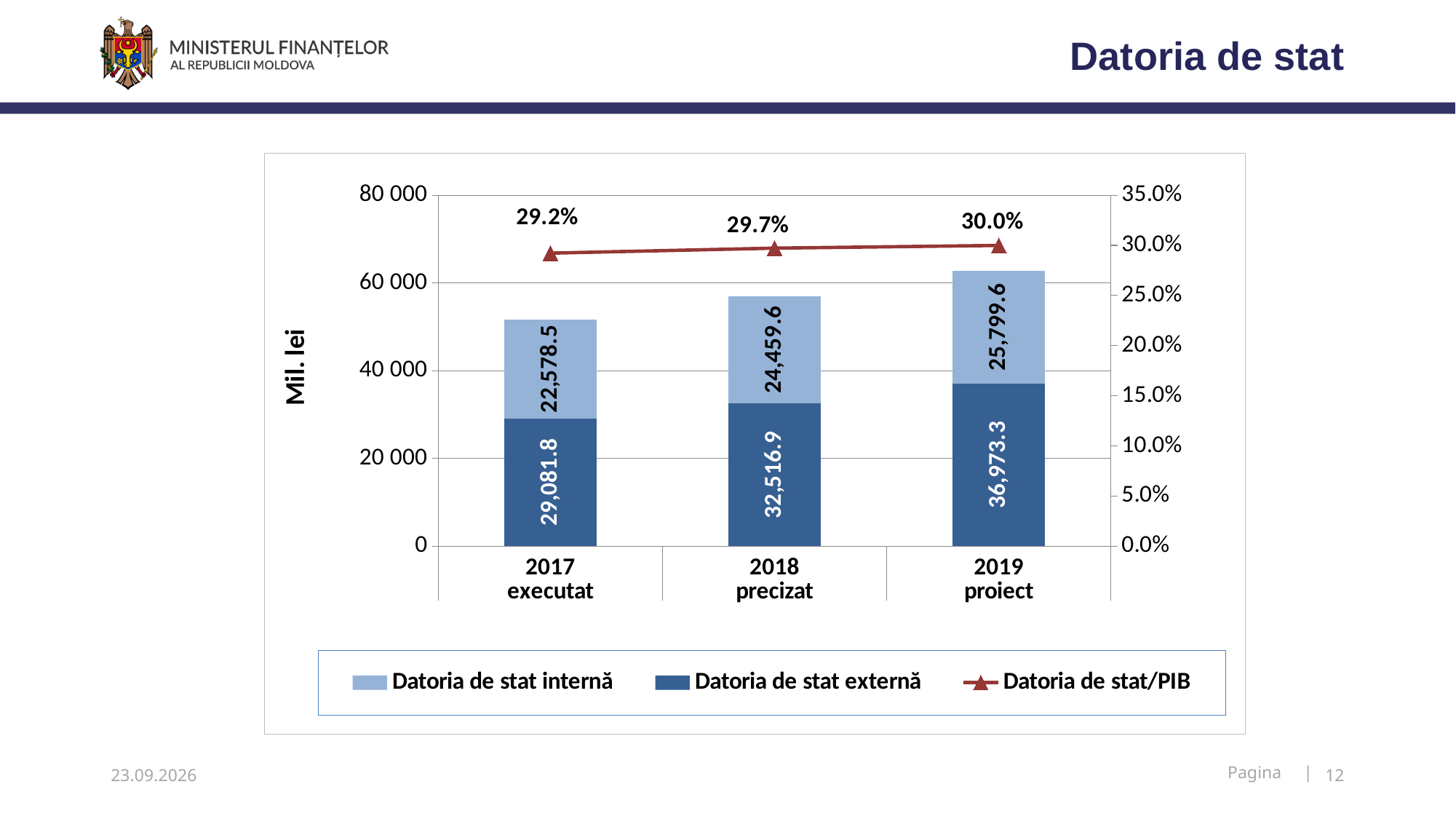
What is the value of Datoria de stat externă for 2019 proiect? 36,973.3 How many categories are shown on the x axis? 3 What is the difference between Datoria de stat externă in 2019 proiect and 2017 executat? 7,891.5 What is the total of the stacked bar for 2018 precizat? 56,976.5 How many series does the legend list? 3 What kind of chart is shown on the slide? Stacked bar chart with a line Does the Datoria de stat/PIB line rise or fall from 2017 executat to 2019 proiect? Rise Which category has the highest Datoria de stat externă value? 2019 proiect What is the value of Datoria de stat internă for 2017 executat? 22,578.5 Which is larger: Datoria de stat internă in 2018 precizat or Datoria de stat externă in 2018 precizat? Datoria de stat externă What is the Datoria de stat/PIB value for 2018 precizat? 29.7% Which category has the lowest Datoria de stat/PIB value? 2017 executat